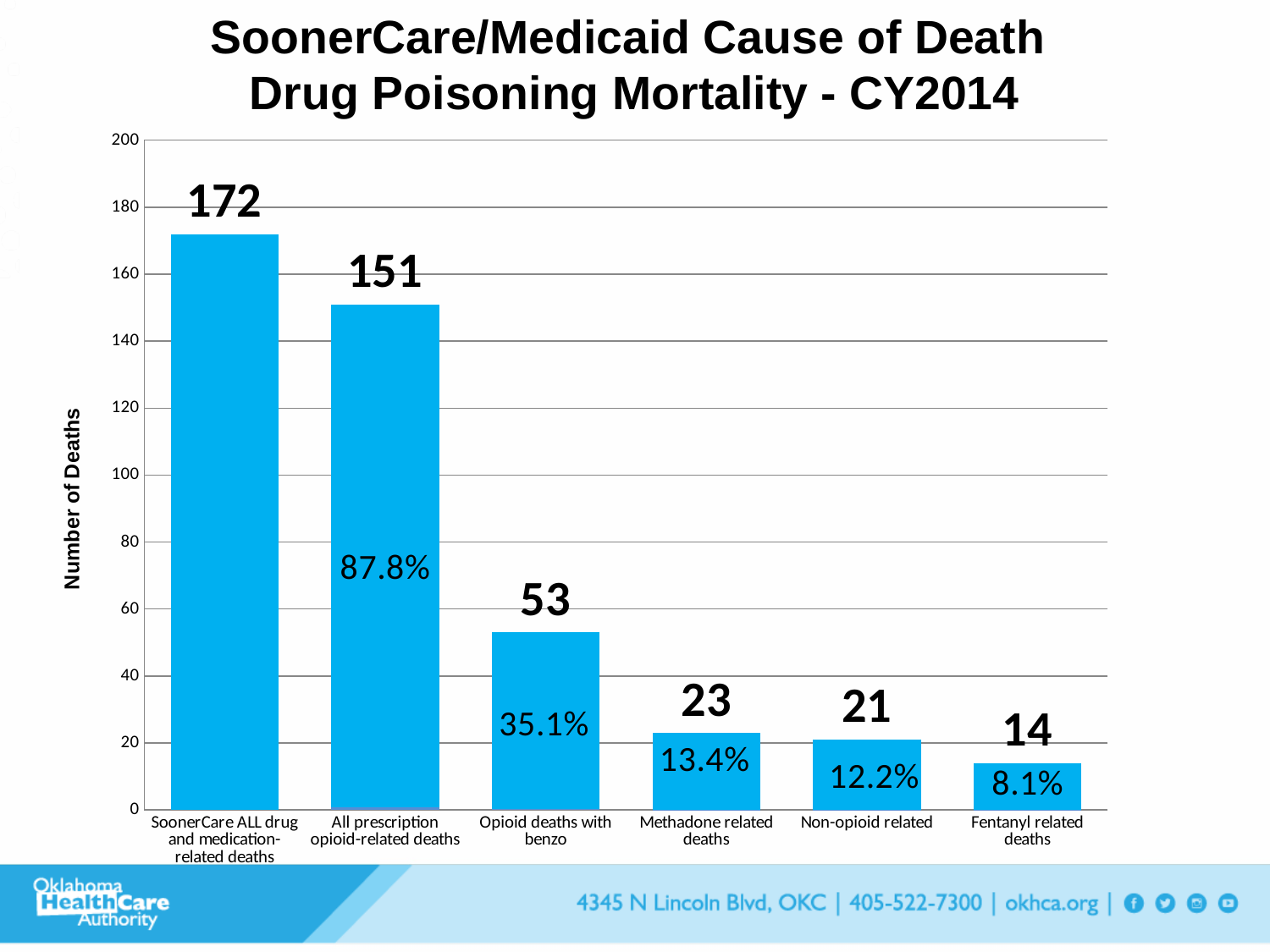
What is the number of deaths for SoonerCare ALL drug and medication-related deaths? 172 Which has more deaths, Methadone related deaths or Non-opioid related? Methadone related deaths What is the number of deaths for All prescription opioid-related deaths? 151 What is the difference in deaths between All prescription opioid-related deaths and Opioid deaths with benzo? 98 Is the value for Opioid deaths with benzo greater or less than 60? less What type of chart is shown on the slide? bar chart Which category has the highest number of deaths? SoonerCare ALL drug and medication-related deaths What percentage is shown on the Opioid deaths with benzo bar? 35.1% What is the label of the vertical axis? Number of Deaths Which category has the lowest number of deaths? Fentanyl related deaths What is the number of Fentanyl related deaths? 14 How many categories are shown on the x axis? 6